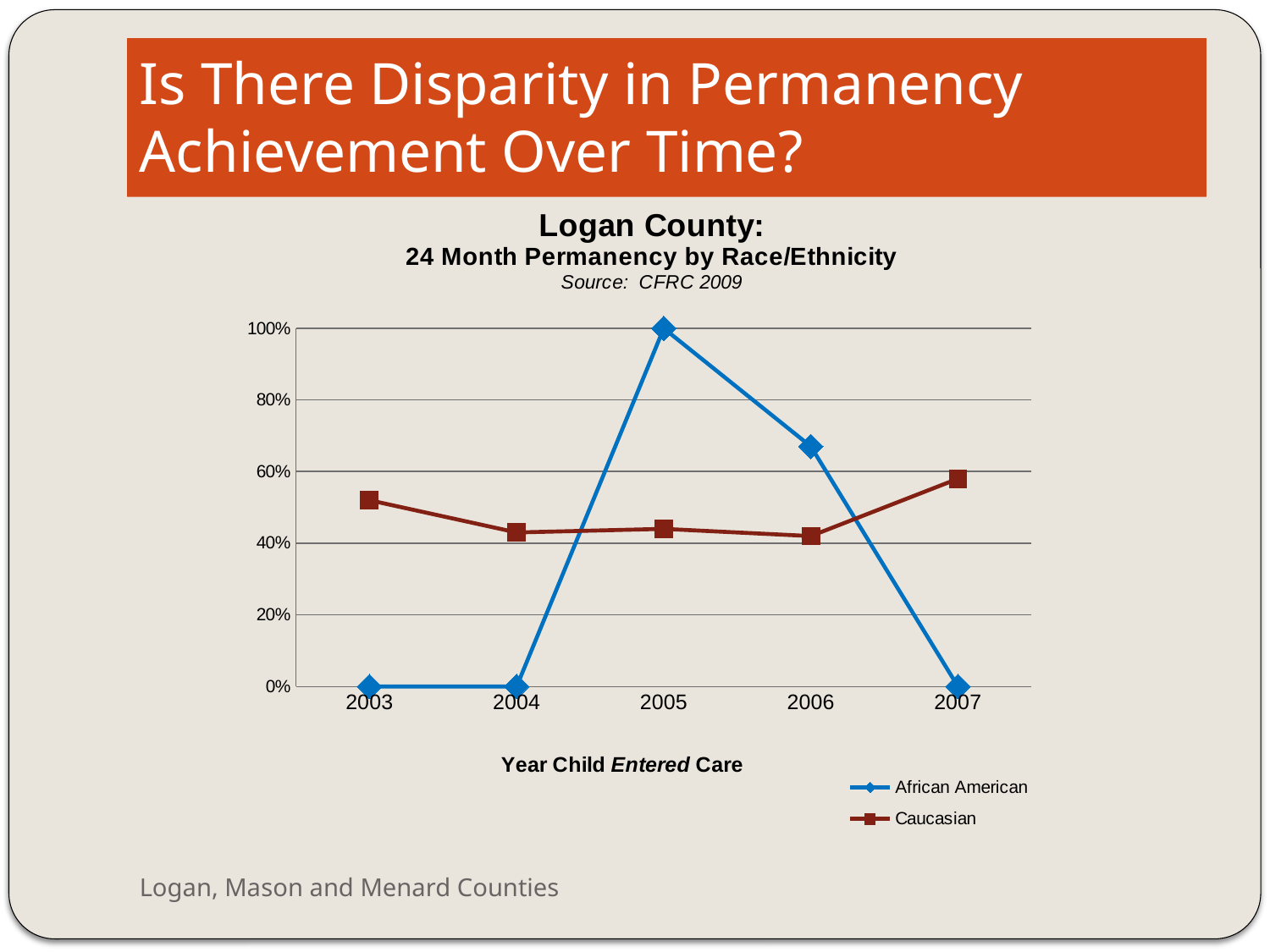
What is the label of the x axis? Year Child Entered Care In which year is the African American series at its highest? 2005 What is the 24 month permanency value for African American children who entered care in 2003? 0% In which year is the Caucasian series at its highest? 2007 What kind of chart is shown on the slide? line chart What is the 24 month permanency value for African American children who entered care in 2005? 100% What is the 24 month permanency value for African American children who entered care in 2007? 0% How many series does the legend list? 2 Is the African American value for 2006 greater or less than 60%? greater How many years are plotted along the x axis? 5 Is the Caucasian value for 2003 greater or less than 40%? greater In 2006, which series has the larger value, African American or Caucasian? African American